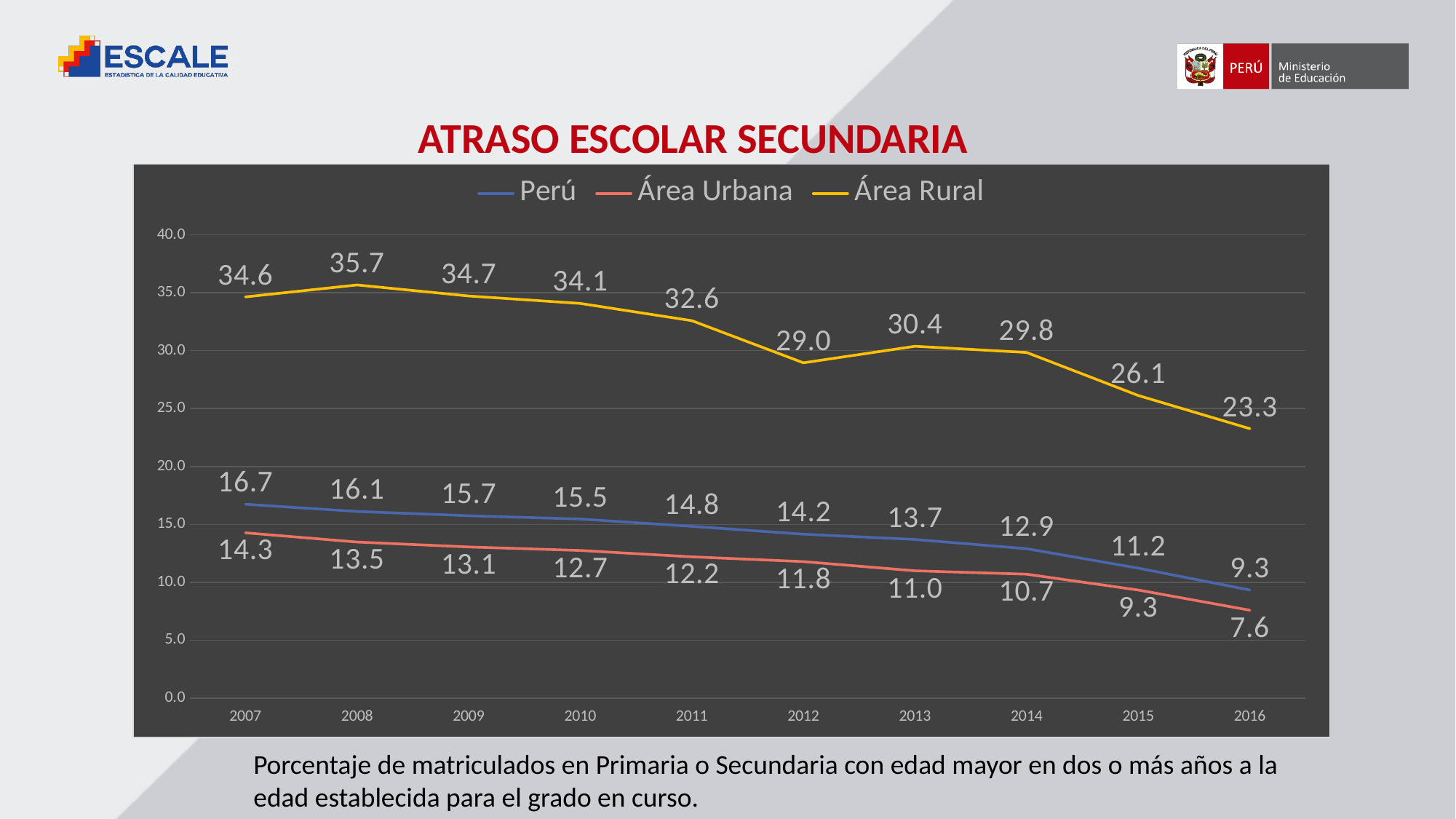
Which is larger in 2014: the Perú value or the Área Urbana value? Perú Does the Perú series rise or fall from 2007 to 2016? fall What is the value for Área Urbana in 2012? 11.8 How many series does the legend list? 3 In which year is the Área Rural value highest? 2008 In which year is the Área Urbana value lowest? 2016 What is the difference between the Área Rural and Área Urbana values in 2007? 20.3 What kind of chart is shown on the slide? line chart How many years are shown on the x axis? 10 Is the value for Área Rural in 2016 greater or less than 25.0? less What is the value for Perú in 2016? 9.3 What is the value for Área Rural in 2008? 35.7